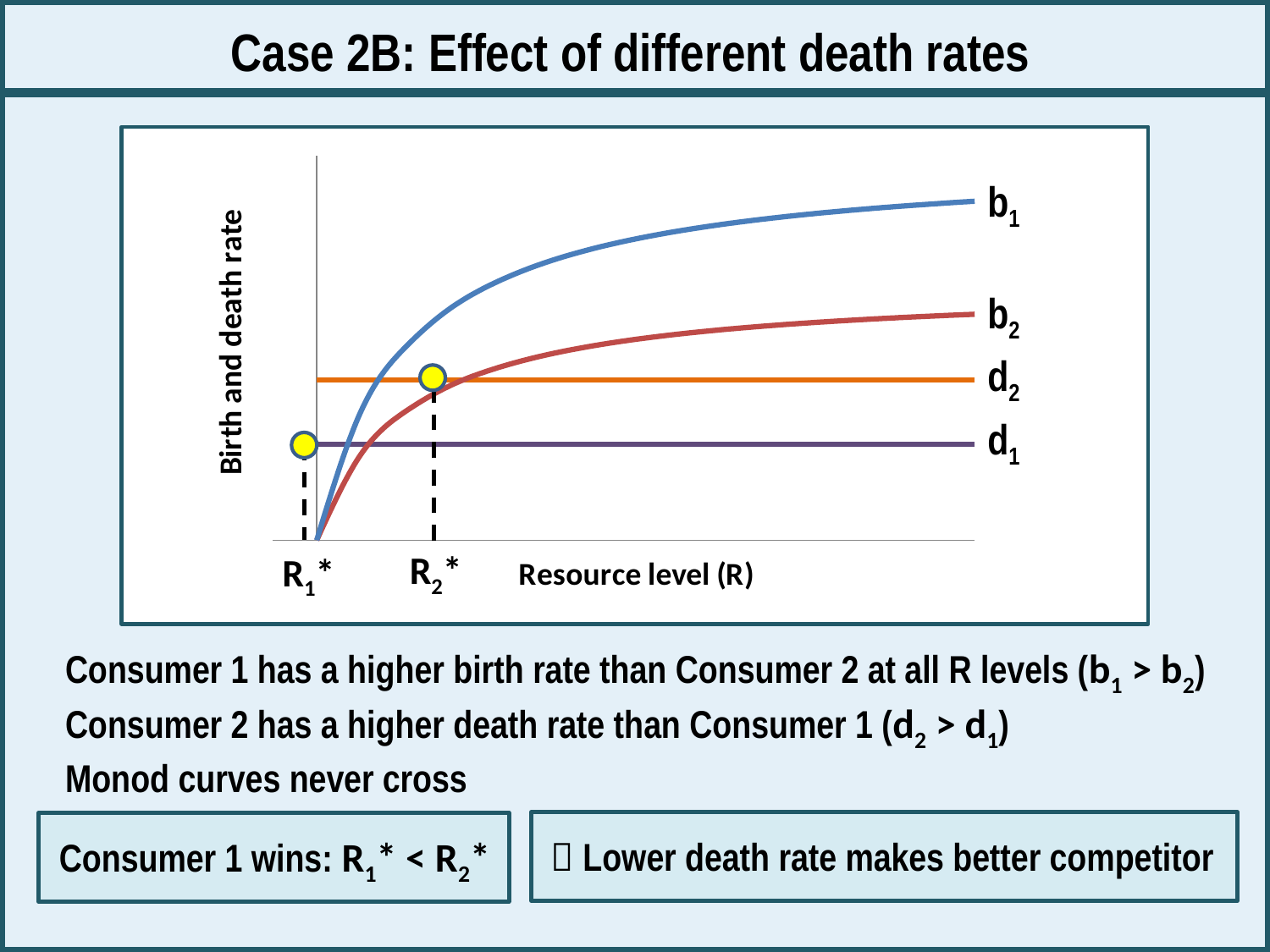
What is the label of the x axis? Resource level (R) What is the label of the y axis? Birth and death rate Does the b1 curve rise or fall as resource level increases? Rises Which is further left on the x axis, R1* or R2*? R1* What kind of chart is shown on the slide? Line chart Which curve does the d2 line intersect at R2*? b2 Which death rate line is higher, d1 or d2? d2 Which line is lowest on the chart? d1 Does the d2 line rise, fall, or stay flat as resource level increases? Stays flat How many curves or lines are plotted on the chart? 4 Which curve is highest at the right-hand end of the chart? b1 Which is higher at all resource levels, b1 or b2? b1